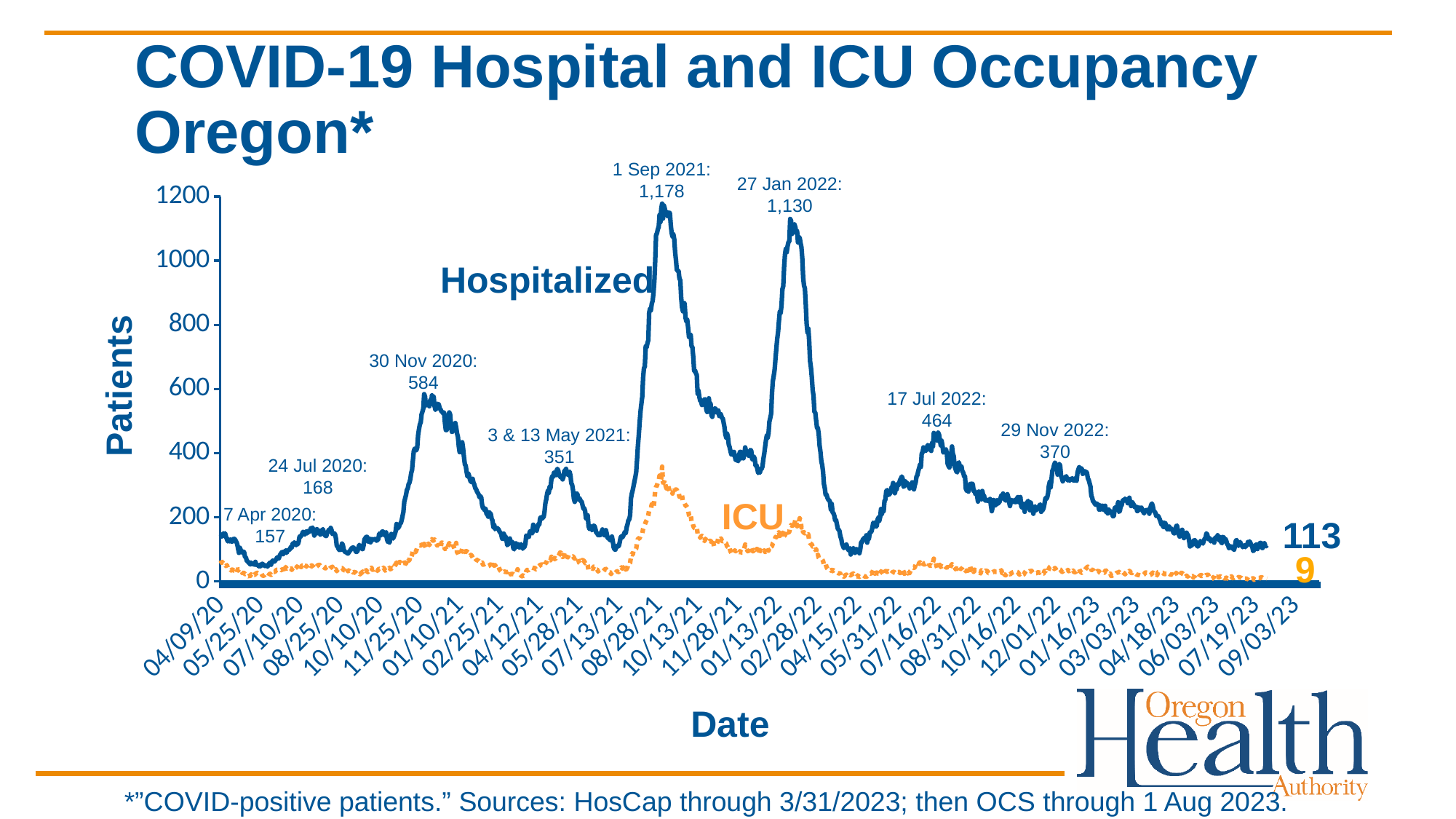
What was the hospitalized patient count at the 30 Nov 2020 peak? 584 What is the difference between the 1 Sep 2021 peak (1,178) and the 27 Jan 2022 peak (1,130)? 48 What is the label on the y-axis of the chart? Patients What was the hospitalized patient count at the 27 Jan 2022 peak? 1,130 How many series are plotted on the chart? 2 What is the final labeled value of the Hospitalized series at the right end of the chart? 113 Is the ICU value at its highest point around September 2021 greater or less than 400? less What is the final labeled value of the ICU series at the right end of the chart? 9 Which labeled peak has the highest number of hospitalized patients? 1 Sep 2021 Which peak was larger: 17 Jul 2022 or 29 Nov 2022? 17 Jul 2022 What was the peak number of hospitalized patients on 1 Sep 2021? 1,178 What kind of chart is shown on the slide? Line chart